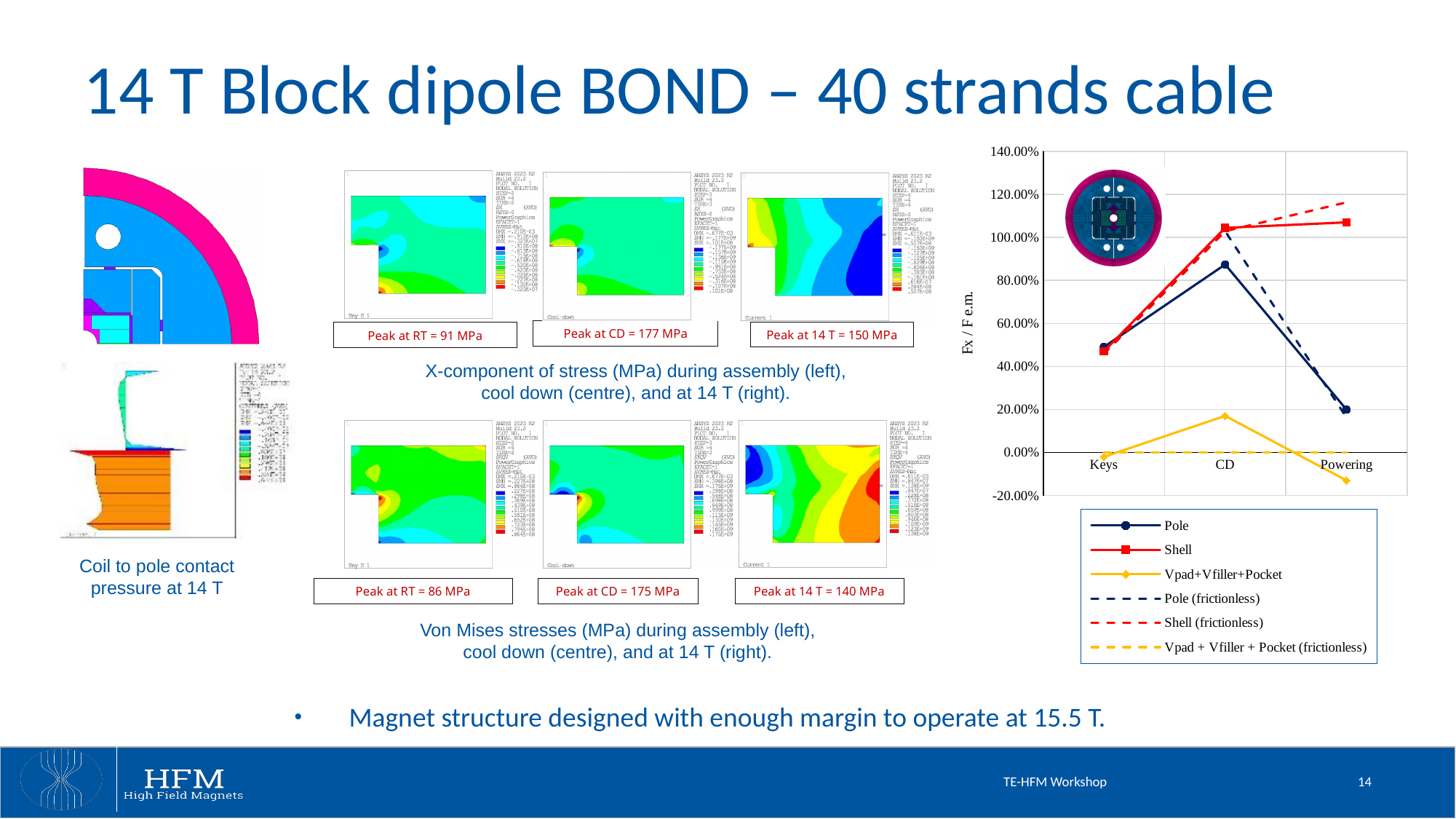
In the line chart, at which category is the Pole series lowest? Powering In the line chart, does the Pole series rise or fall from CD to Powering? fall In the line chart, at Powering, which is larger: the Shell value or the Pole value? Shell In the line chart, at which category is the Vpad+Vfiller+Pocket series highest? CD In the line chart, is the Pole value at CD greater or less than 80.00%? greater In the line chart, at which category is the Pole series highest? CD What kind of chart is shown on the right side of the slide? line chart How many series does the legend of the line chart list? 6 In the line chart, is the Shell value at Powering greater or less than 100.00%? greater In the line chart, is the Vpad+Vfiller+Pocket value at Powering greater or less than 0.00%? less How many categories are shown on the x axis of the line chart? 3 What is the label of the y axis of the line chart? Fx / F e.m.